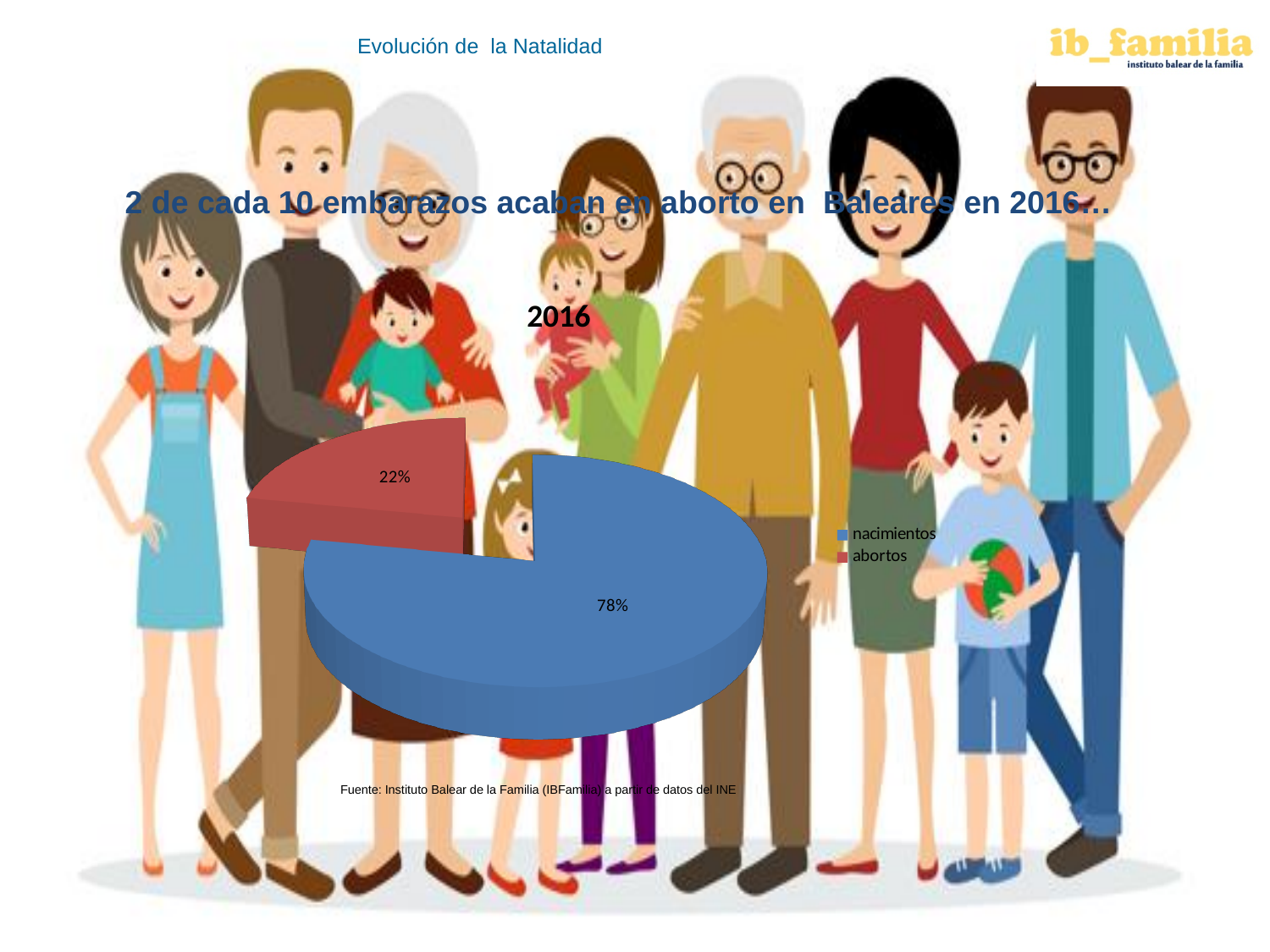
What is the difference in percentage points between nacimientos and abortos? 56 Which slice is the smallest? abortos How many slices does the pie chart have? 2 What colour is the abortos slice? red What share of the pie does abortos represent? 22% Which slice is the largest? nacimientos What is the chart's title? 2016 What share of the pie does nacimientos represent? 78% Which is larger, the share for nacimientos or the share for abortos? nacimientos How many entries does the legend list? 2 What kind of chart is shown on the slide? pie chart